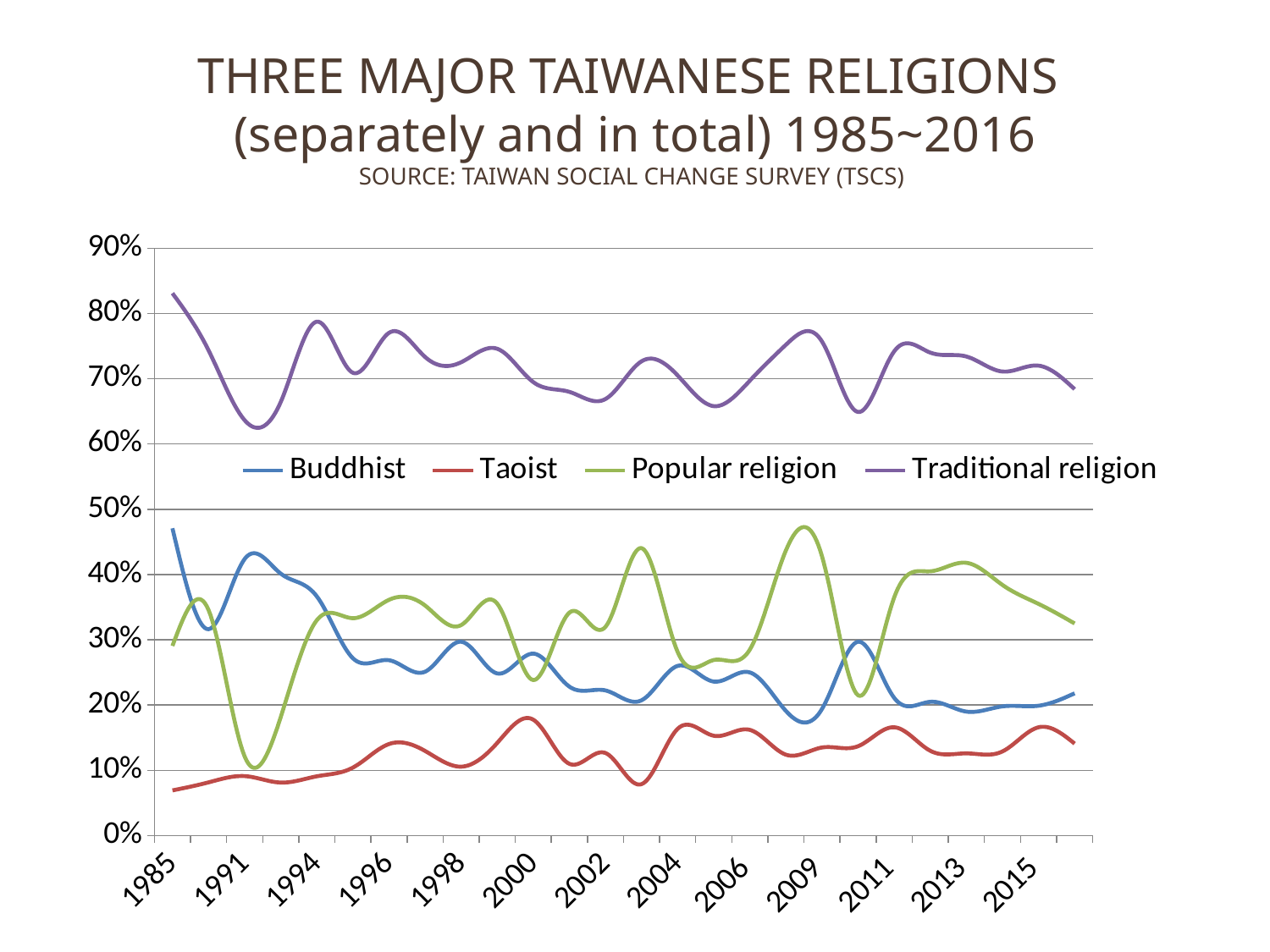
What source is cited under the chart title? Taiwan Social Change Survey (TSCS) Which series has the lowest values across the whole period? Taoist Is the value for Taoist in 1985 greater or less than 10%? less Is the value for Popular religion in 2009 greater or less than 40%? greater How many series does the legend list? 4 Which series has the highest values across the whole period? Traditional religion Which series does the legend list in purple? Traditional religion Is the value for Traditional religion in 1985 greater or less than 80%? greater In 1985, which is larger: the Buddhist value or the Popular religion value? Buddhist What kind of chart is shown on the slide? Line chart Does the Buddhist line overall rise or fall from 1985 to 2015? Fall